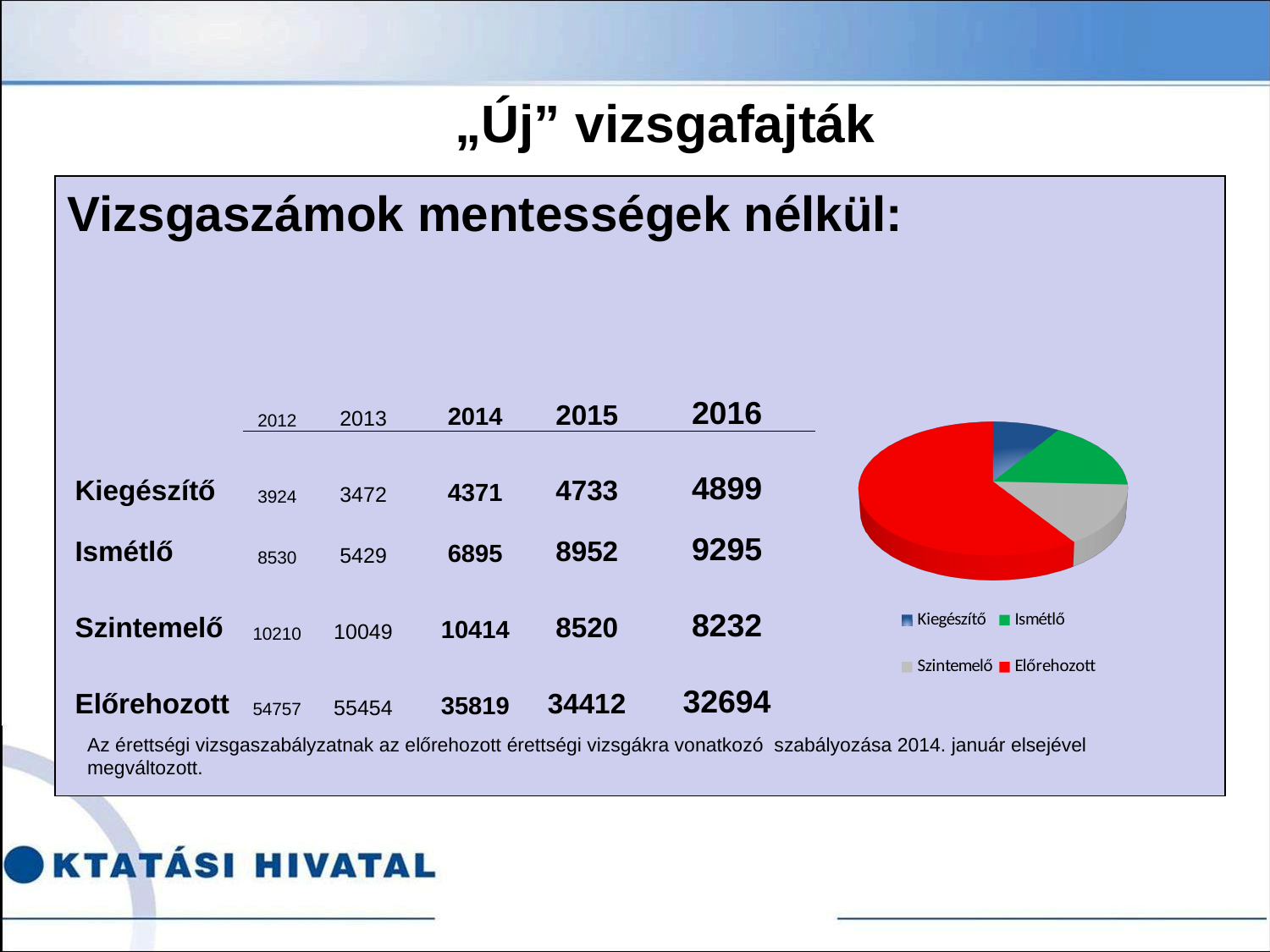
How many slices does the pie chart have? 4 Which category has the largest slice in the pie chart? Előrehozott In the pie chart, which slice is larger: Szintemelő or Kiegészítő? Szintemelő How many entries does the pie chart's legend list? 4 What kind of chart is shown on the right side of the slide? pie chart Which category has the smallest slice in the pie chart? Kiegészítő In the pie chart, which slice is larger: Előrehozott or Kiegészítő? Előrehozott What colour is the Előrehozott slice in the pie chart? red Which category is shown in green in the pie chart? Ismétlő